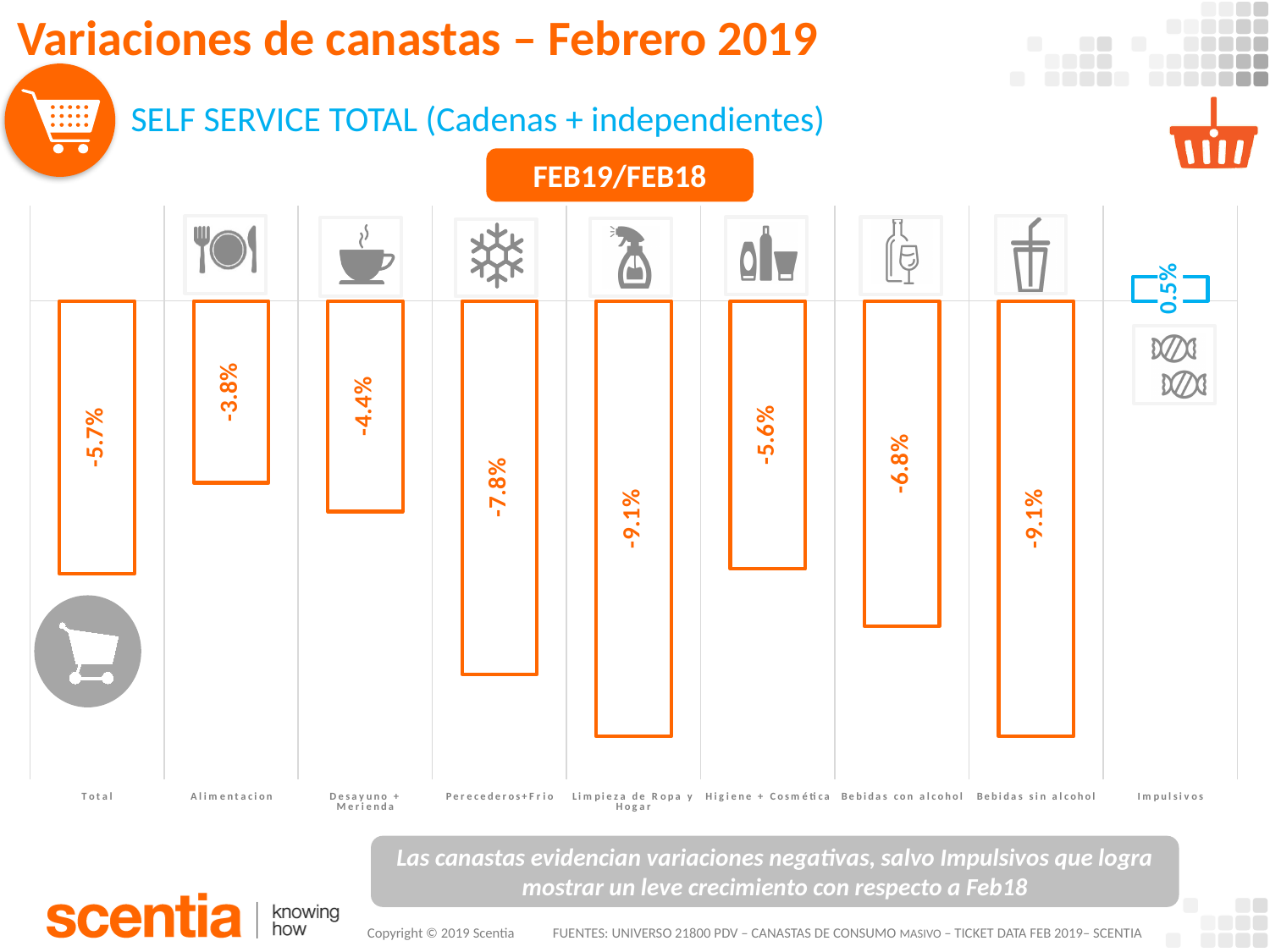
What is the difference between the values for Alimentacion and Perecederos+Frio? 4.0 percentage points What period comparison is labelled above the chart? FEB19/FEB18 Which category is the only one with a positive variation? Impulsivos What is the value shown for Total? -5.7% What is the value shown for Perecederos+Frio? -7.8% What is the value shown for Impulsivos? 0.5% What kind of chart is shown on the slide? Bar chart How many categories are shown in the chart? 9 Which is larger, the value for Higiene + Cosmética or the value for Bebidas con alcohol? Higiene + Cosmética Which category has the highest value? Impulsivos What is the value shown for Bebidas con alcohol? -6.8% What is the value shown for Alimentacion? -3.8%